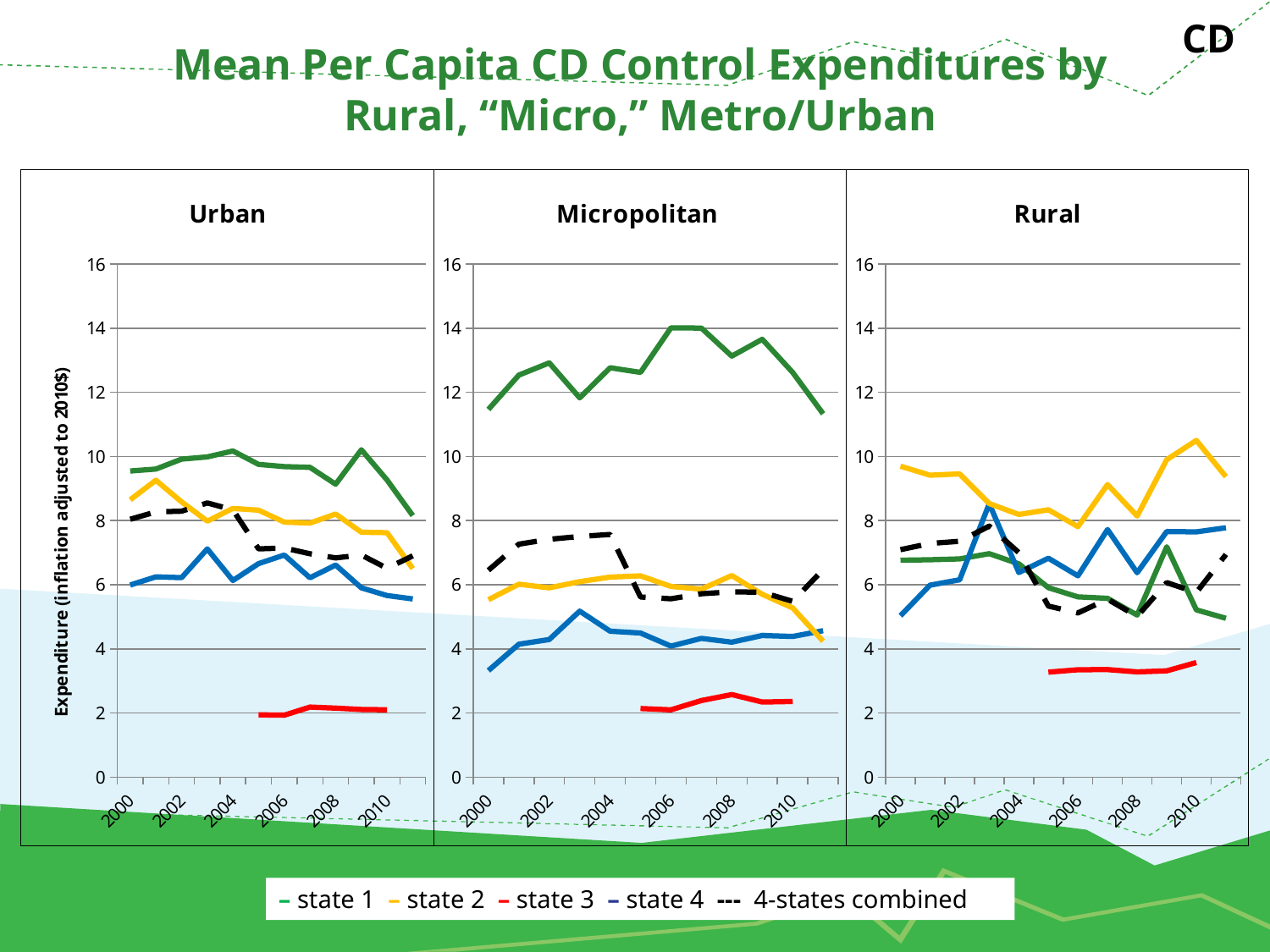
How many separate chart panels are shown on the slide? 3 In the Micropolitan chart, is the value for state 1 in 2006 greater or less than 12? greater In the Rural chart, is the value for state 2 in 2010 greater or less than 8? greater Which series in the legend is drawn as a dashed black line? 4-states combined In the Micropolitan chart, which series has the highest values across the years? state 1 How many series does the legend list? 5 In the Urban chart, is the value for state 3 in 2008 greater or less than 4? less In the Urban chart, which is larger in 2004: state 1 or state 4? state 1 In the Rural chart, which series has the lowest values? state 3 What kind of chart is used in the Urban panel? line chart In the Micropolitan chart, does the state 1 line rise or fall from 2009 to 2011? fall